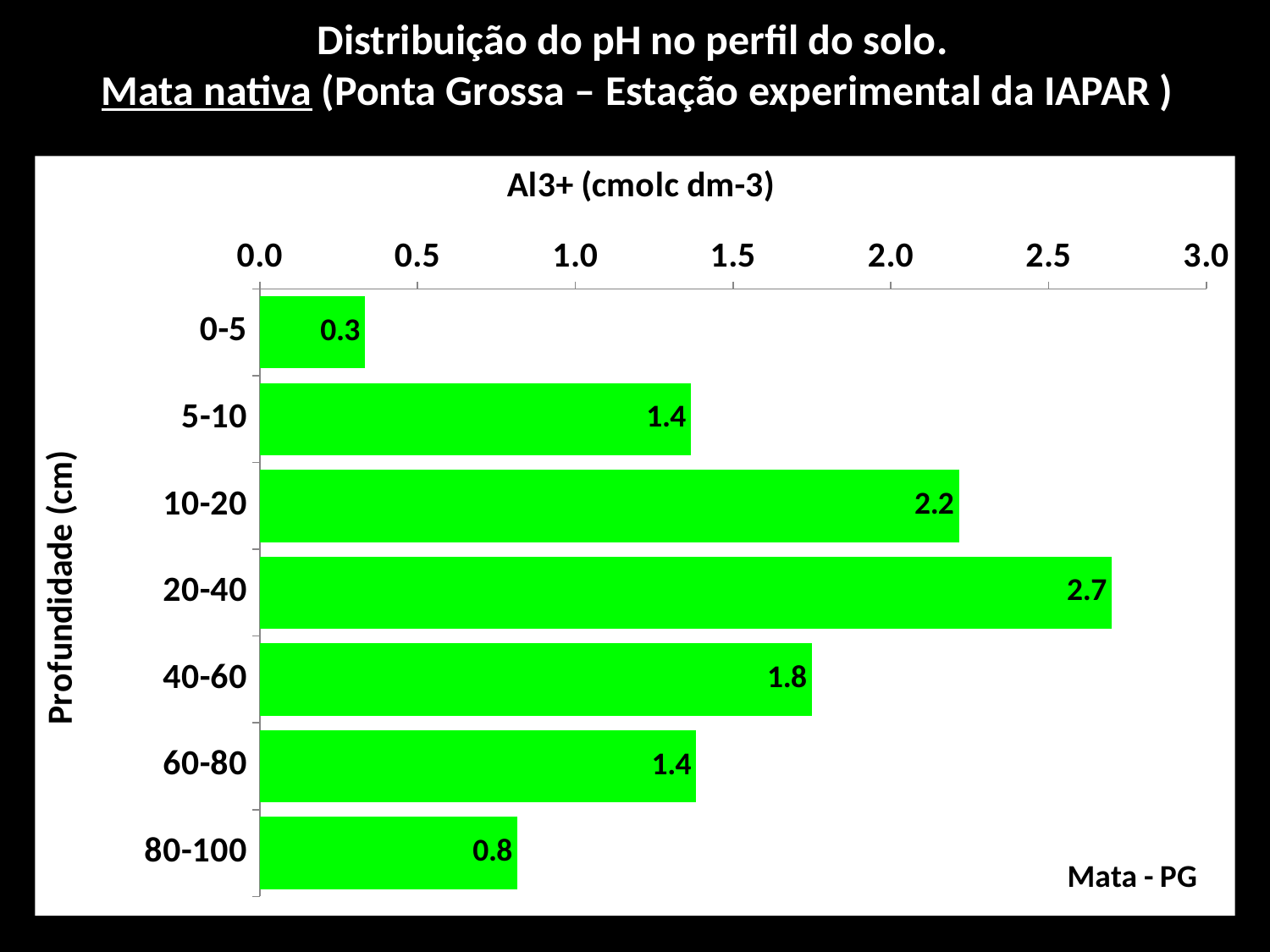
Which depth has the highest Al3+ value? 20-40 What is the Al3+ value for the 0-5 cm depth? 0.3 What is the label on the vertical axis of the chart? Profundidade (cm) How many depth categories are shown in the chart? 7 Is the Al3+ value for the 5-10 cm depth greater or less than 1.0? greater Which depth has the lowest Al3+ value? 0-5 What is the Al3+ value for the 80-100 cm depth? 0.8 What kind of chart is shown on the slide? bar chart What is the Al3+ value for the 40-60 cm depth? 1.8 What is the Al3+ value for the 20-40 cm depth? 2.7 Which has a larger Al3+ value, the 10-20 cm depth or the 40-60 cm depth? 10-20 What is the difference between the Al3+ values at 20-40 cm and 10-20 cm? 0.5